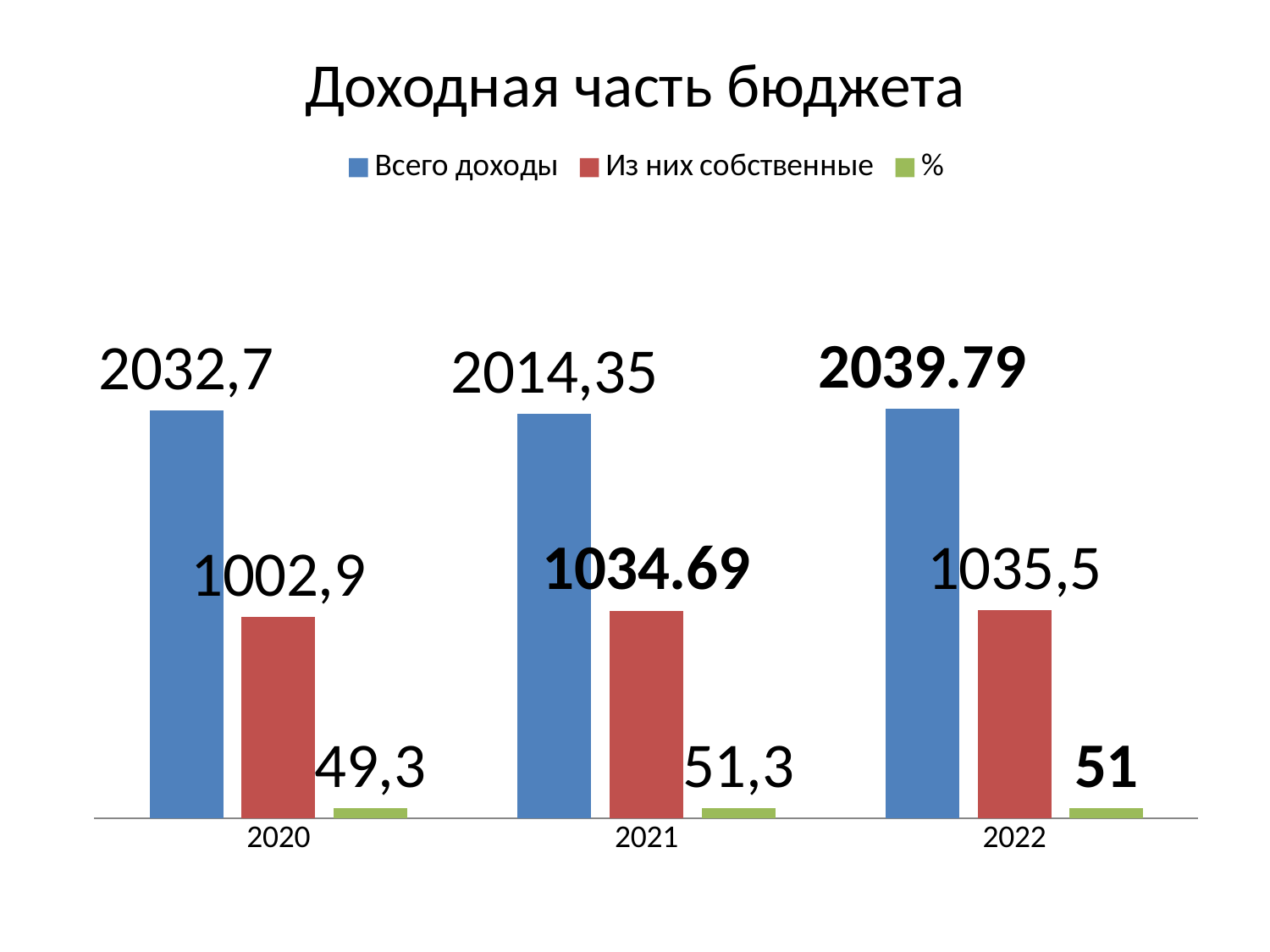
What is the % value for 2022? 51 How many series does the legend list? 3 In which year is Всего доходы the lowest? 2021 What is the value of Всего доходы for 2022? 2039.79 What kind of chart is shown on the slide? bar chart What is the value of Из них собственные for 2021? 1034.69 In which year is the % value the highest? 2021 What is the difference between Всего доходы and Из них собственные in 2020? 1029,8 In which year is Из них собственные the lowest? 2020 How many years are shown on the x axis? 3 Which is larger, Всего доходы in 2020 or in 2021? 2020 What is the value of Всего доходы for 2020? 2032,7